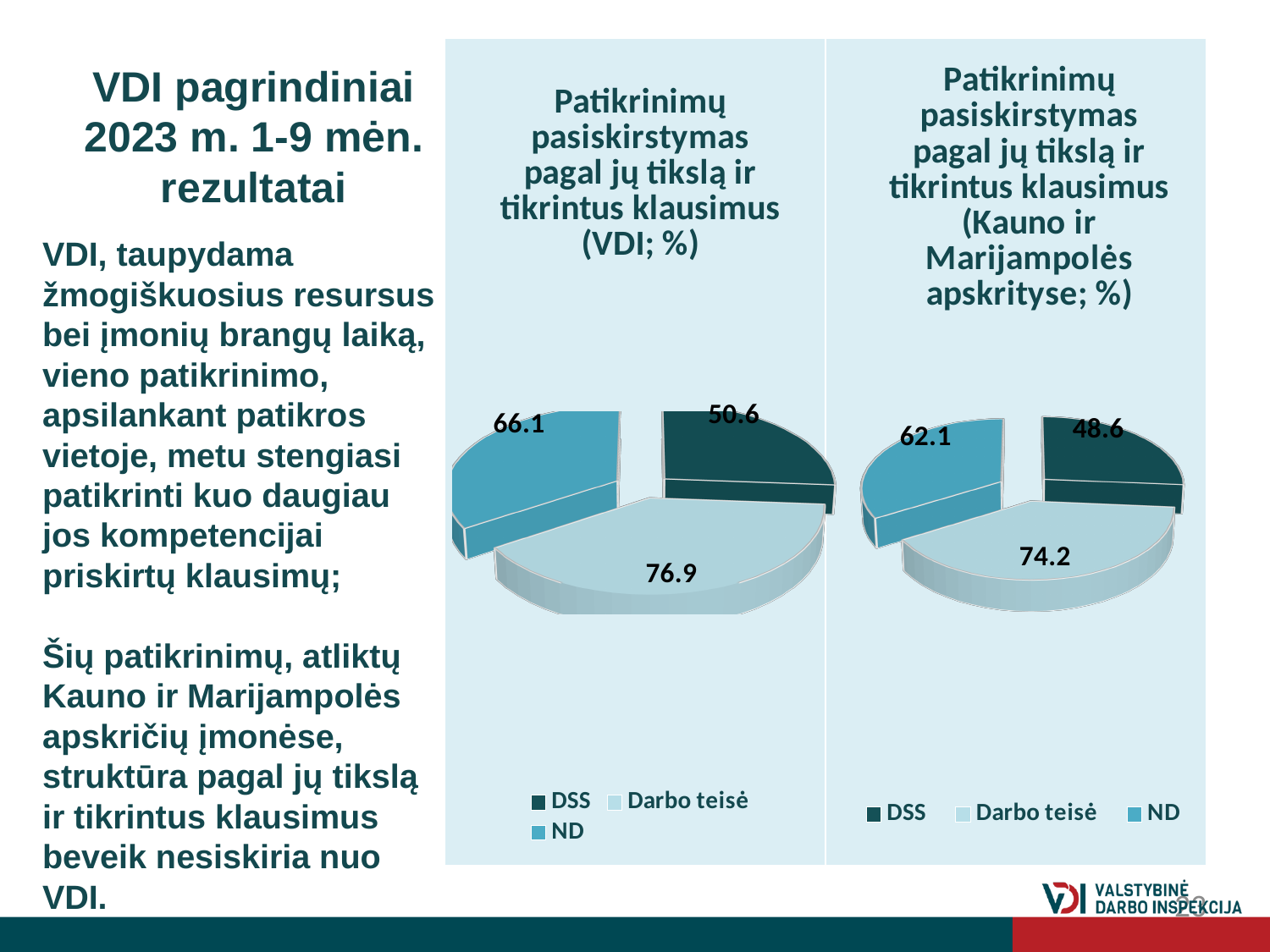
In the right chart (Kauno ir Marijampolės apskrityse; %), which category has the lowest value? DSS How many categories does the right chart (Kauno ir Marijampolės apskrityse; %) show? 3 Which is larger: the value for ND in the left chart (VDI; %) or the value for ND in the right chart (Kauno ir Marijampolės apskrityse; %)? ND in the left chart (VDI; %) In the left chart (VDI; %), which category has the highest value? Darbo teisė In the right chart (Kauno ir Marijampolės apskrityse; %), what is the difference between the values for Darbo teisė and ND? 12.1 In the left chart (VDI; %), what is the value for DSS? 50.6 What kind of chart is the left chart (VDI; %)? Pie chart In the right chart (Kauno ir Marijampolės apskrityse; %), what is the value for DSS? 48.6 In the right chart (Kauno ir Marijampolės apskrityse; %), what is the value for ND? 62.1 In the left chart (VDI; %), what is the difference between the values for ND and DSS? 15.5 What are the legend entries of the left chart (VDI; %)? DSS, Darbo teisė, ND In the left chart (VDI; %), what is the value for Darbo teisė? 76.9